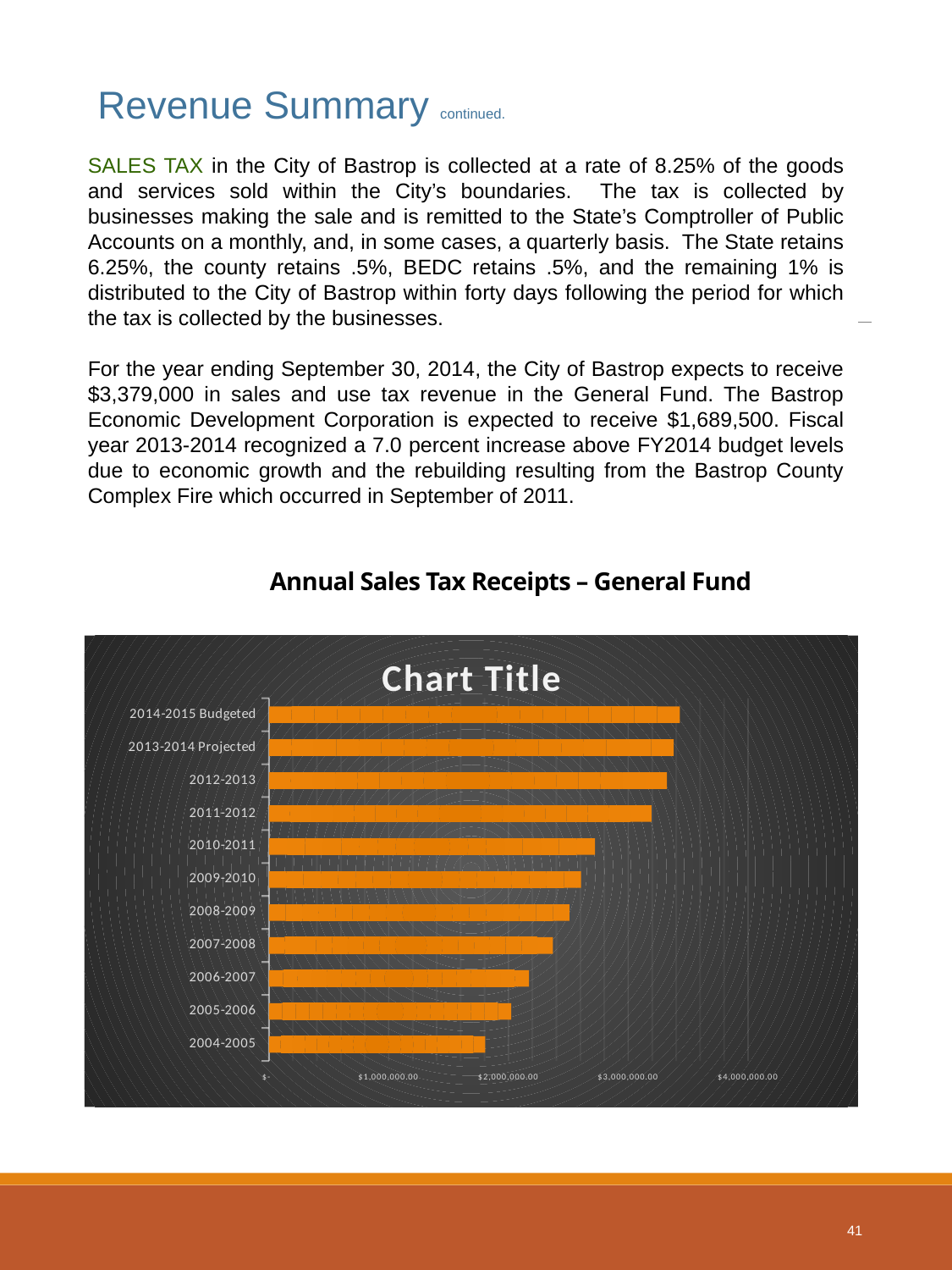
What title is printed inside the chart area? Chart Title Which is larger, the value for 2012-2013 or the value for 2008-2009? 2012-2013 Is the value for 2006-2007 greater or less than $2,000,000.00? greater Is the value for 2014-2015 Budgeted greater or less than $3,000,000.00? greater What colour are the bars in the chart? orange Which is larger, the value for 2010-2011 or the value for 2004-2005? 2010-2011 Which fiscal year has the lowest sales tax receipts in the chart? 2004-2005 Is the value for 2004-2005 greater or less than $2,000,000.00? less Do the sales tax receipts generally rise or fall from 2004-2005 to 2014-2015 Budgeted? rise What kind of chart is shown on the slide? bar chart How many fiscal-year categories are plotted in the chart? 11